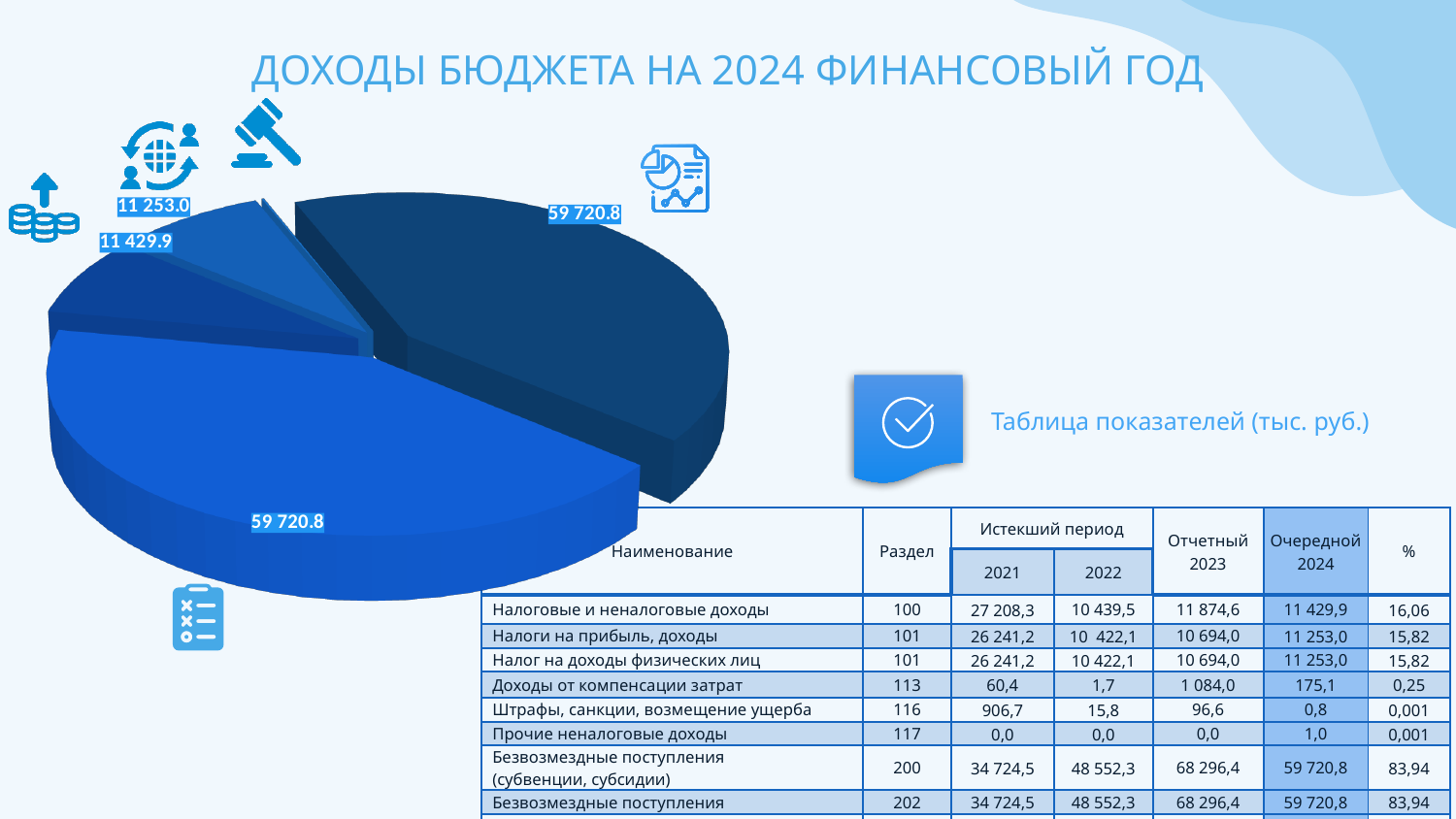
What value is printed on the large slice at the bottom of the pie chart? 59 720.8 What is the largest value printed as a data label on the pie chart? 59 720.8 How many slices of the pie chart are labelled 59 720.8? 2 Which of the two small slices has the larger value, the one labelled 11 429.9 or the one labelled 11 253.0? 11 429.9 What is the title shown above the chart on the slide? ДОХОДЫ БЮДЖЕТА НА 2024 ФИНАНСОВЫЙ ГОД What is the smallest value printed as a data label on the pie chart? 11 253.0 How many slices does the pie chart have? 4 Does the pie chart have a legend? No What is the difference between the slice labelled 11 429.9 and the slice labelled 11 253.0? 176.9 What kind of chart is shown on the slide? pie chart